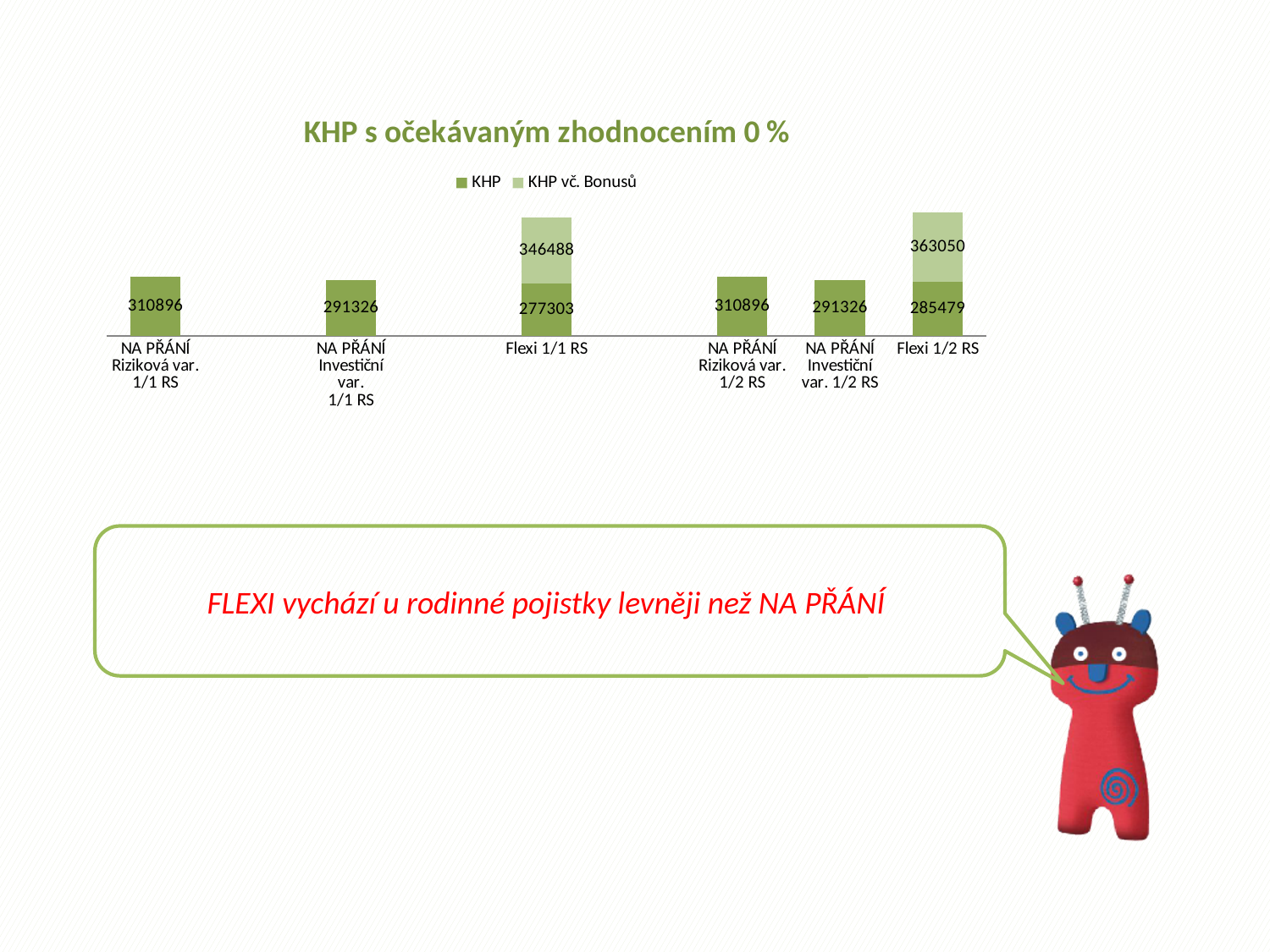
How many series does the chart legend list? 2 What is the KHP value for Flexi 1/2 RS? 285479 What value is labelled on the KHP vč. Bonusů segment for Flexi 1/2 RS? 363050 What is the KHP value for Flexi 1/1 RS? 277303 How many categories are shown on the x axis of the chart? 6 What is the difference between the KHP values for NA PŘÁNÍ Riziková var. 1/1 RS and NA PŘÁNÍ Investiční var. 1/1 RS? 19570 Which category has the lowest KHP value? Flexi 1/1 RS What is the KHP value for NA PŘÁNÍ Investiční var. 1/1 RS? 291326 What is the title of the chart? KHP s očekávaným zhodnocením 0 % What is the KHP value for NA PŘÁNÍ Riziková var. 1/1 RS? 310896 What kind of chart is shown on the slide? bar chart Which is larger, the KHP value for NA PŘÁNÍ Riziková var. 1/2 RS or for Flexi 1/2 RS? NA PŘÁNÍ Riziková var. 1/2 RS